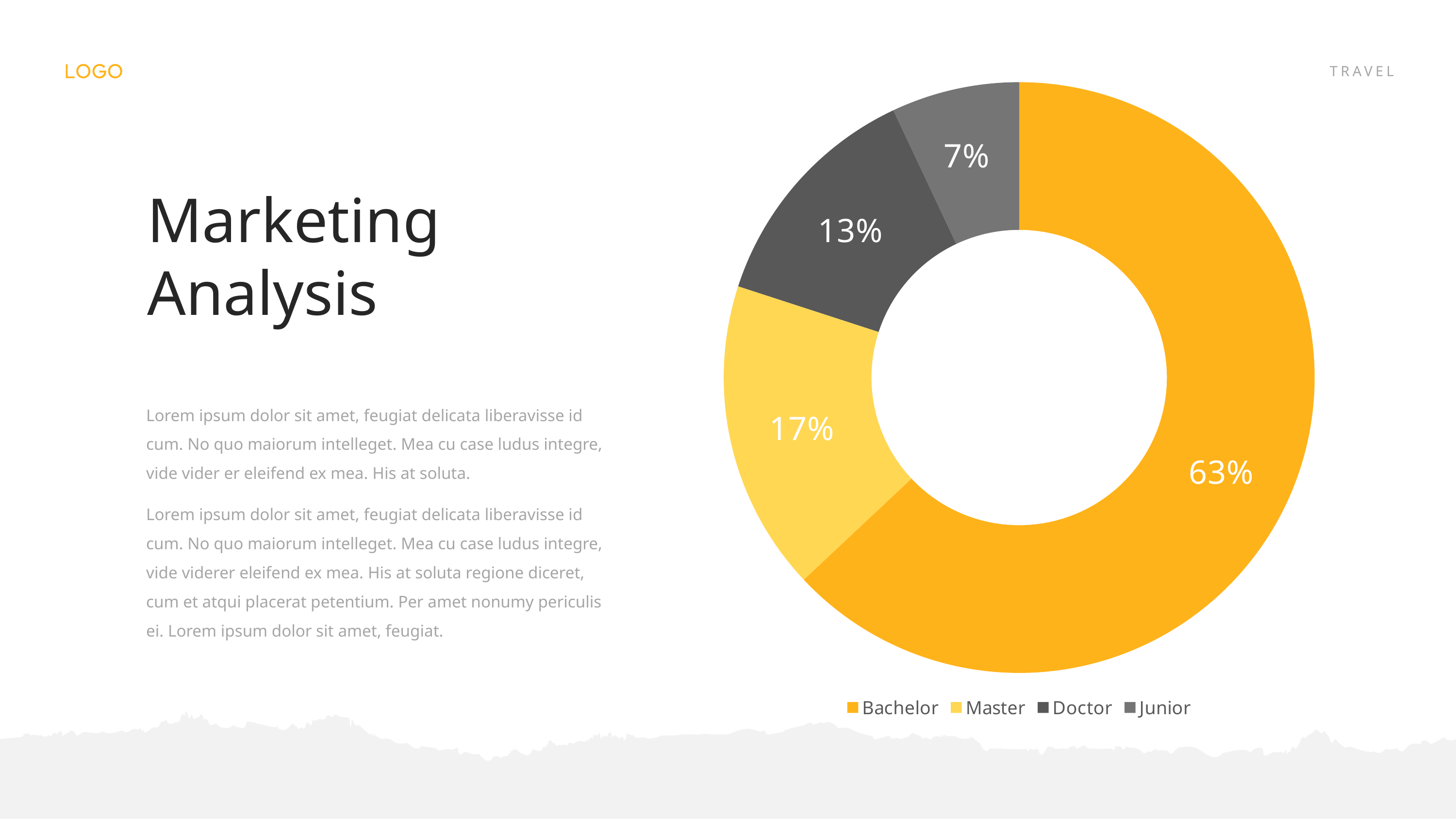
Which is larger, the Master slice or the Doctor slice? Master What kind of chart is shown on the slide? Doughnut chart What is the difference in percentage points between the Doctor and Junior slices? 6 What percentage does the Junior slice represent? 7% What colour is the Bachelor slice in the chart? Orange How many categories are shown in the chart? 4 What percentage does the Master slice represent? 17% What is the difference in percentage points between the Bachelor and Master slices? 46 What percentage does the Doctor slice represent? 13% What percentage does the Bachelor slice represent? 63% Which category has the largest share of the chart? Bachelor Which category has the smallest share of the chart? Junior